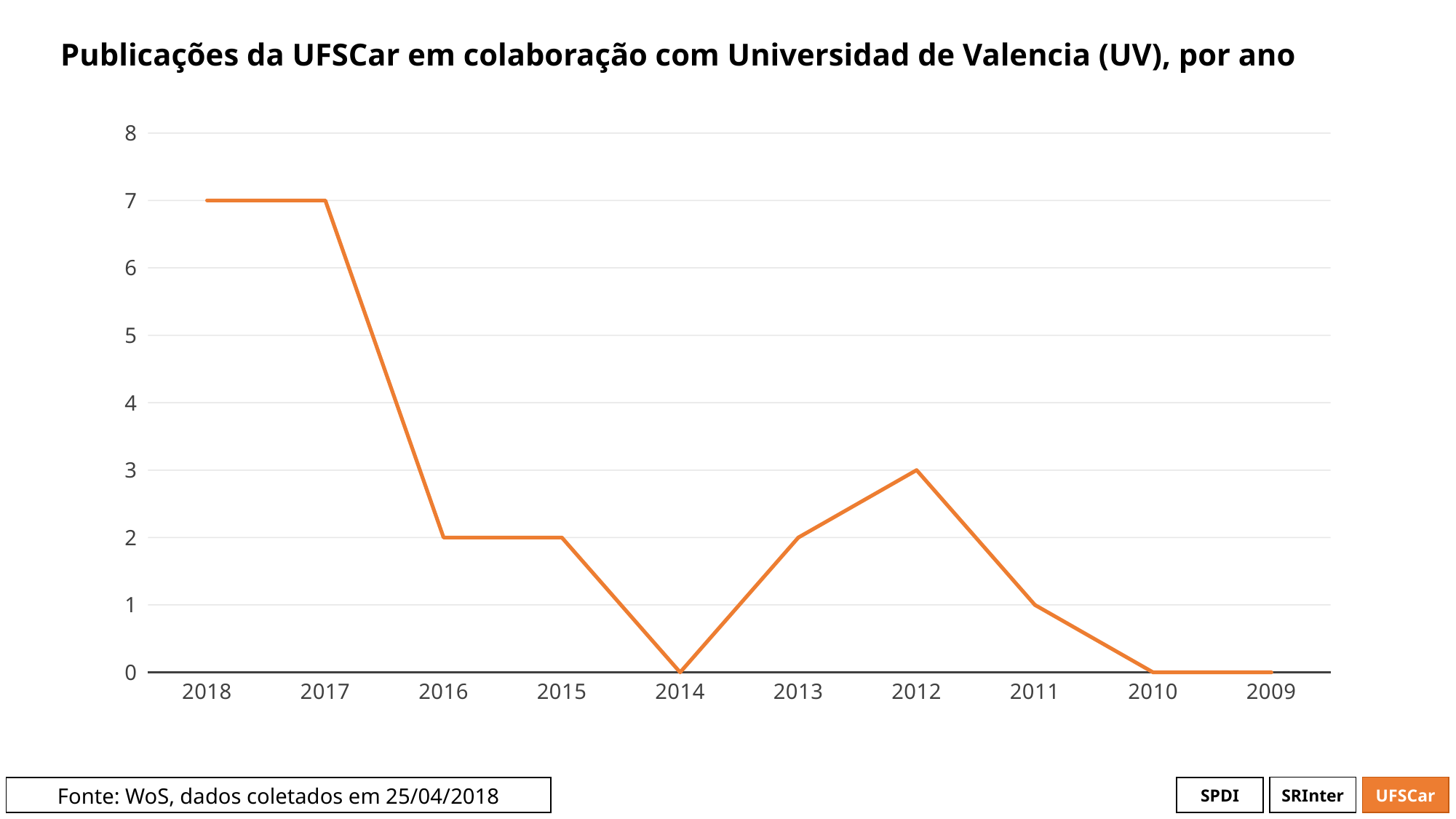
What is the value for 2018? 7 What is the value for 2011? 1 How many years are shown on the x axis? 10 What is the value for 2012? 3 What is the value for 2016? 2 What is the difference between the values for 2017 and 2016? 5 Is the value for 2016 greater or less than 4? less What is the highest value plotted on the chart? 7 What kind of chart is shown on the slide? line chart Which year has the larger value, 2012 or 2013? 2012 What is the lowest value plotted on the chart? 0 What is the value for 2014? 0